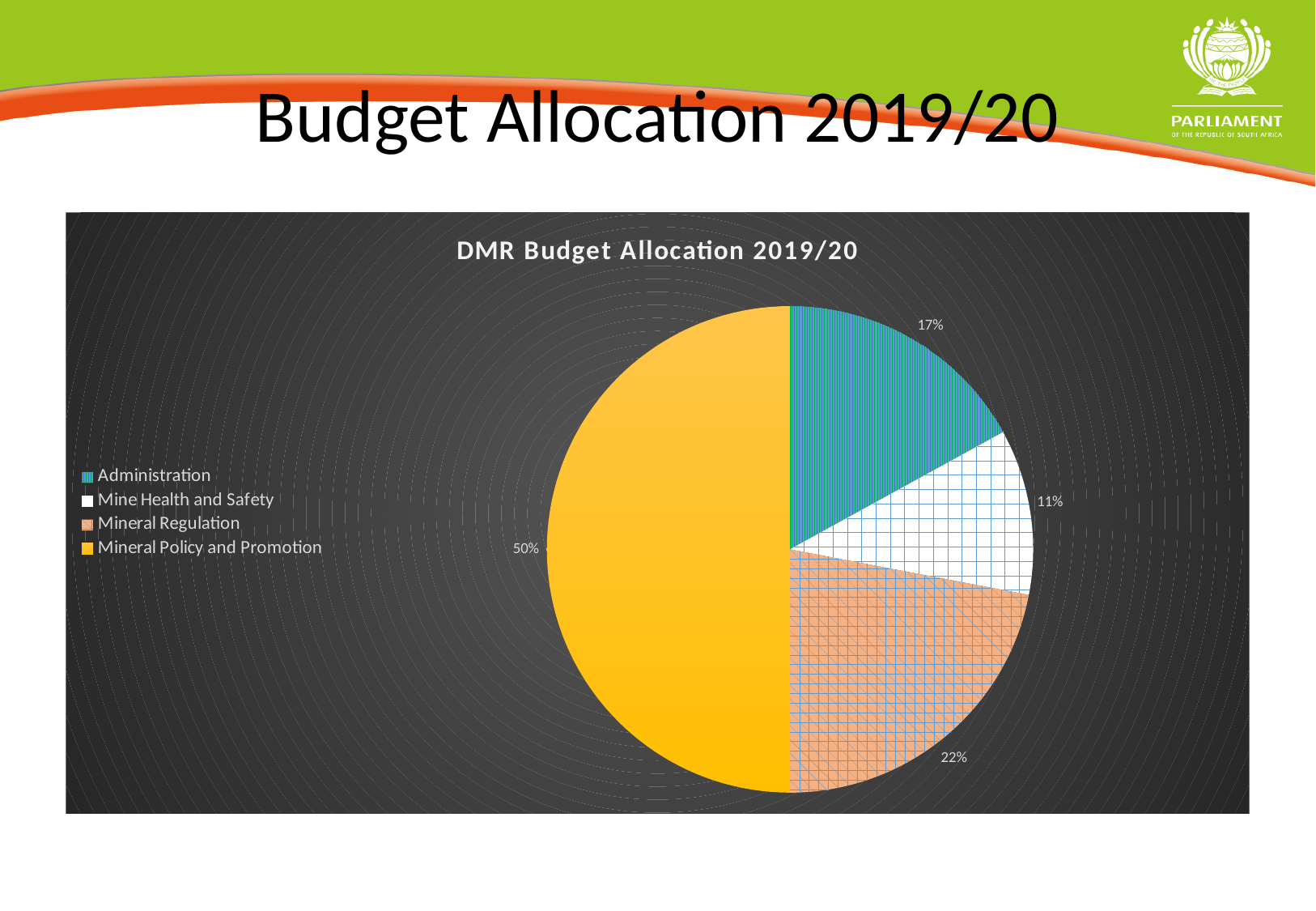
Which receives a larger share, Administration or Mine Health and Safety? Administration What type of chart is shown on the slide? pie chart What share of the budget is allocated to Mineral Policy and Promotion? 50% Which colour represents Mineral Policy and Promotion in the legend? yellow What share of the budget is allocated to Mineral Regulation? 22% Which programme receives the smallest share of the budget? Mine Health and Safety What is the difference in percentage points between Mineral Regulation and Administration? 5 How many categories does the pie chart show? 4 Which programme receives the largest share of the budget? Mineral Policy and Promotion What share of the budget is allocated to Mine Health and Safety? 11% What share of the budget is allocated to Administration? 17% What is the title of the chart? DMR Budget Allocation 2019/20